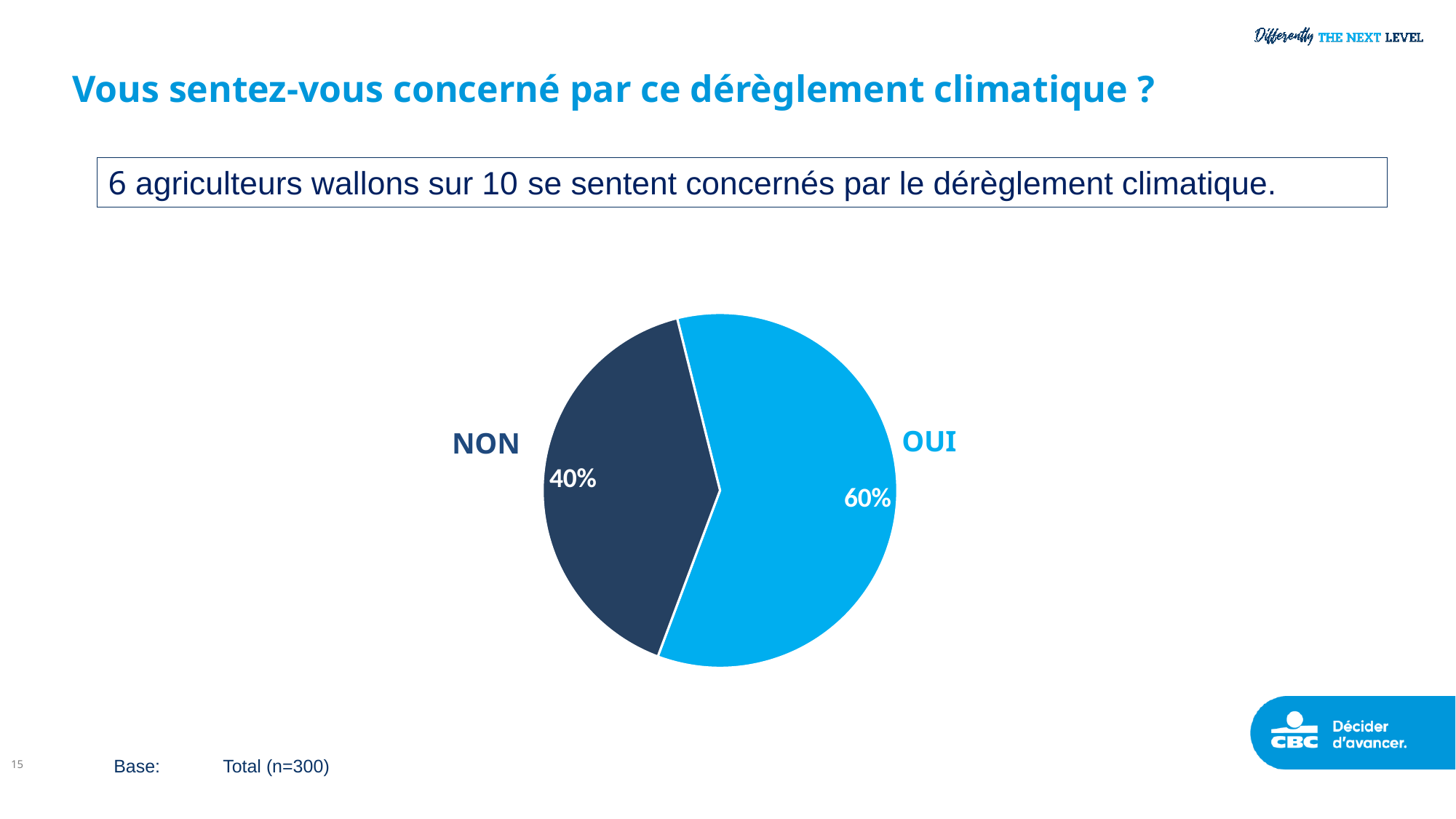
Which slice of the pie is the smallest? NON What share of the pie does the NON slice represent? 40% What share of the pie does the OUI slice represent? 60% Which slice of the pie is the largest? OUI How many slices does the pie chart have? 2 What is the base (sample size) stated for the chart? Total (n=300) What is the difference in percentage points between the OUI and NON slices? 20 percentage points What percentage of respondents answered OUI? 60% What percentage of respondents answered NON? 40% What colour is the OUI slice of the pie? Light blue Which is larger, the OUI slice or the NON slice? OUI What kind of chart is shown on the slide? Pie chart